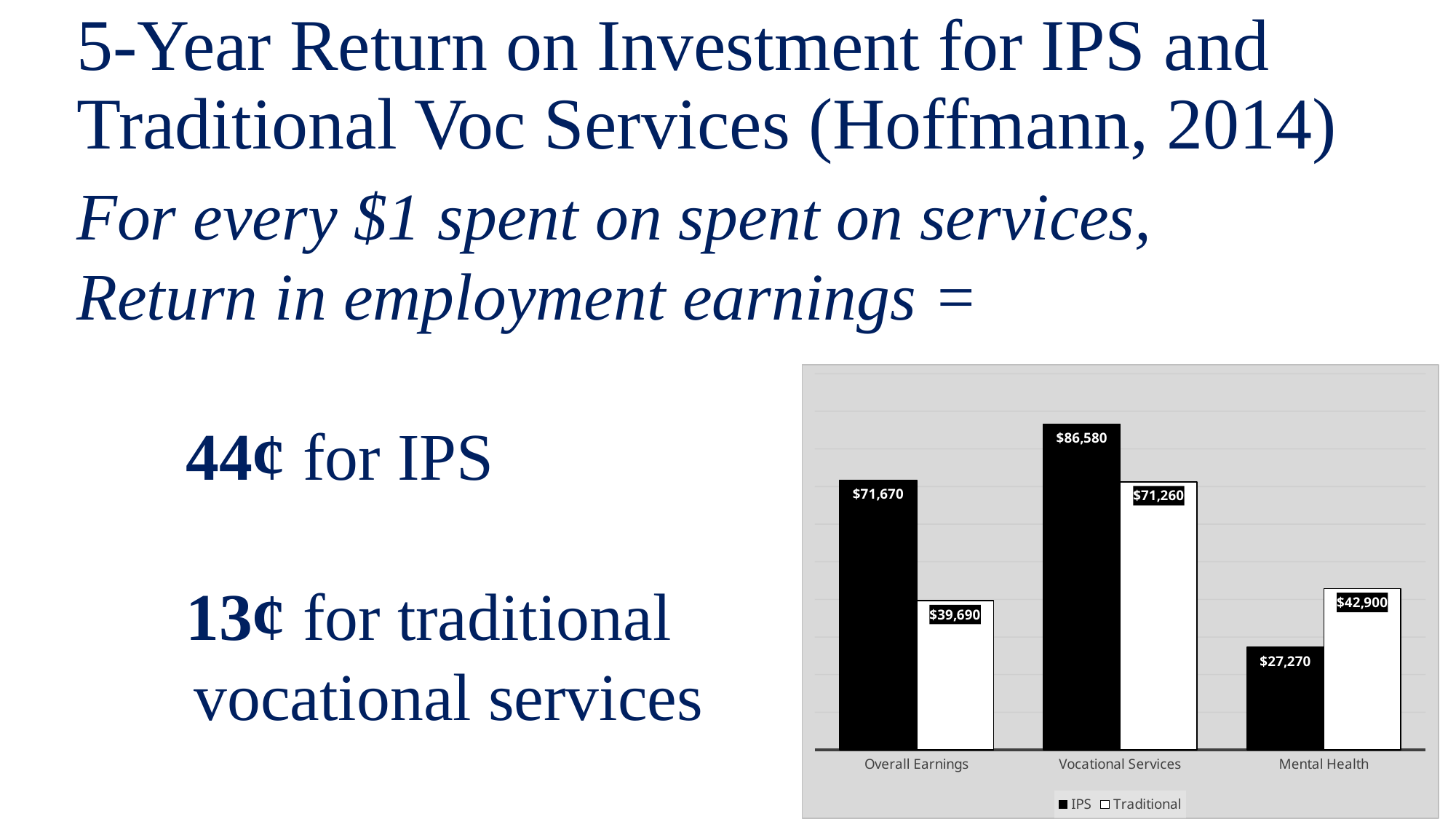
Which is larger for Mental Health, the IPS value or the Traditional value? Traditional What is the difference between the IPS and Traditional values for Overall Earnings? $31,980 What is the IPS value for Mental Health? $27,270 What is the Traditional value for Vocational Services? $71,260 What is the IPS value for Overall Earnings? $71,670 What kind of chart is shown on the slide? Bar chart What is the Traditional value for Mental Health? $42,900 How many categories are shown on the x axis of the chart? 3 Which category has the lowest Traditional value? Overall Earnings Which category has the highest IPS value? Vocational Services Which series is shown with black bars? IPS How many series does the chart legend list? 2